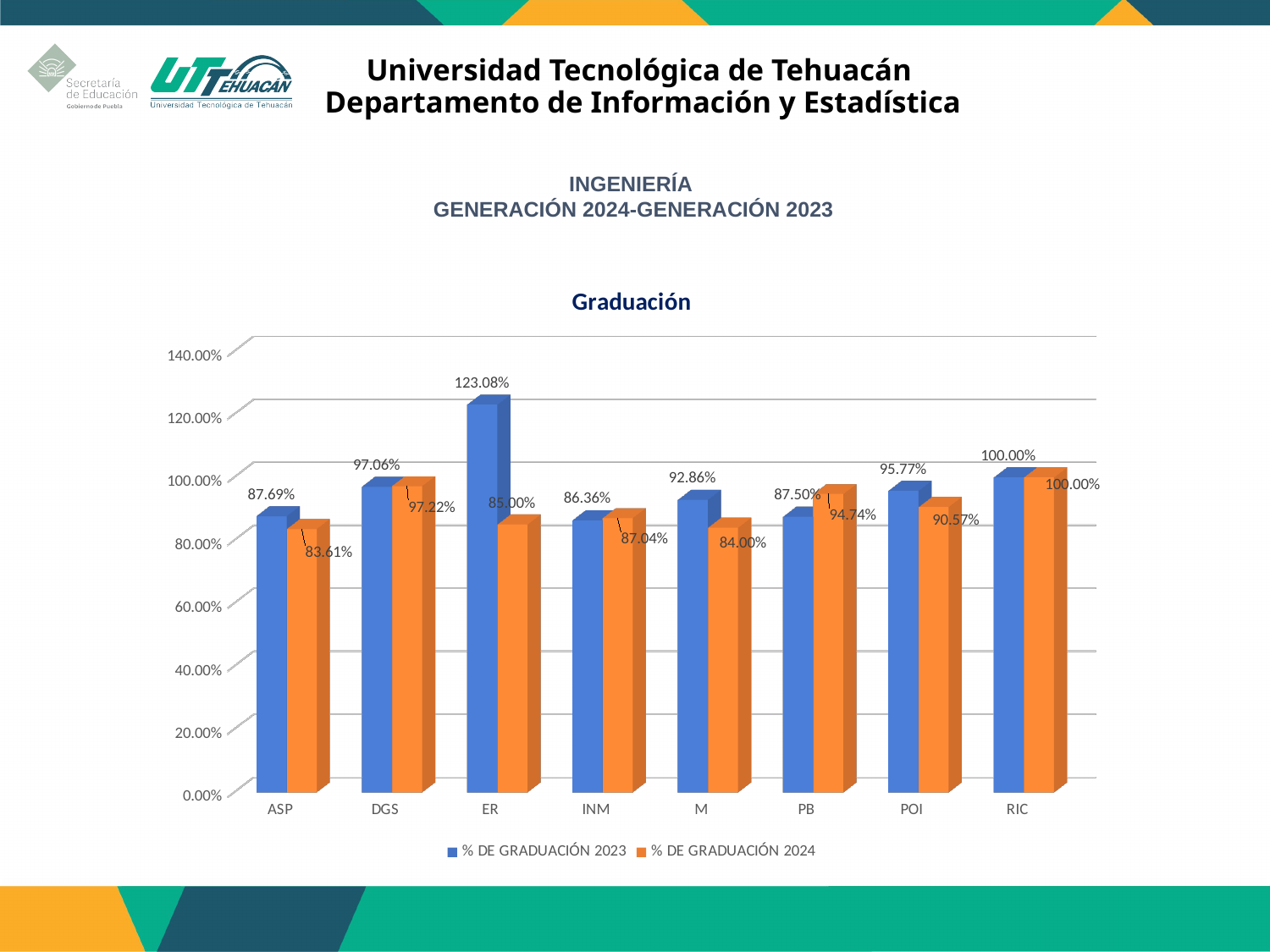
Is the % DE GRADUACIÓN 2023 value for ER greater or less than 120.00%? greater What kind of chart is shown on the slide? Bar chart Which category has the lowest % DE GRADUACIÓN 2024 value? ASP How many categories are shown on the x axis of the chart? 8 How many series does the legend list? 2 What is the % DE GRADUACIÓN 2023 value for ER? 123.08% What is the difference between the 2023 and 2024 graduation percentages for ER? 38.08 percentage points For POI, which is larger: the % DE GRADUACIÓN 2023 or the % DE GRADUACIÓN 2024? % DE GRADUACIÓN 2023 What is the title of the chart? Graduación Which category has the highest % DE GRADUACIÓN 2023 value? ER What is the % DE GRADUACIÓN 2024 value for PB? 94.74% What is the % DE GRADUACIÓN 2024 value for ASP? 83.61%